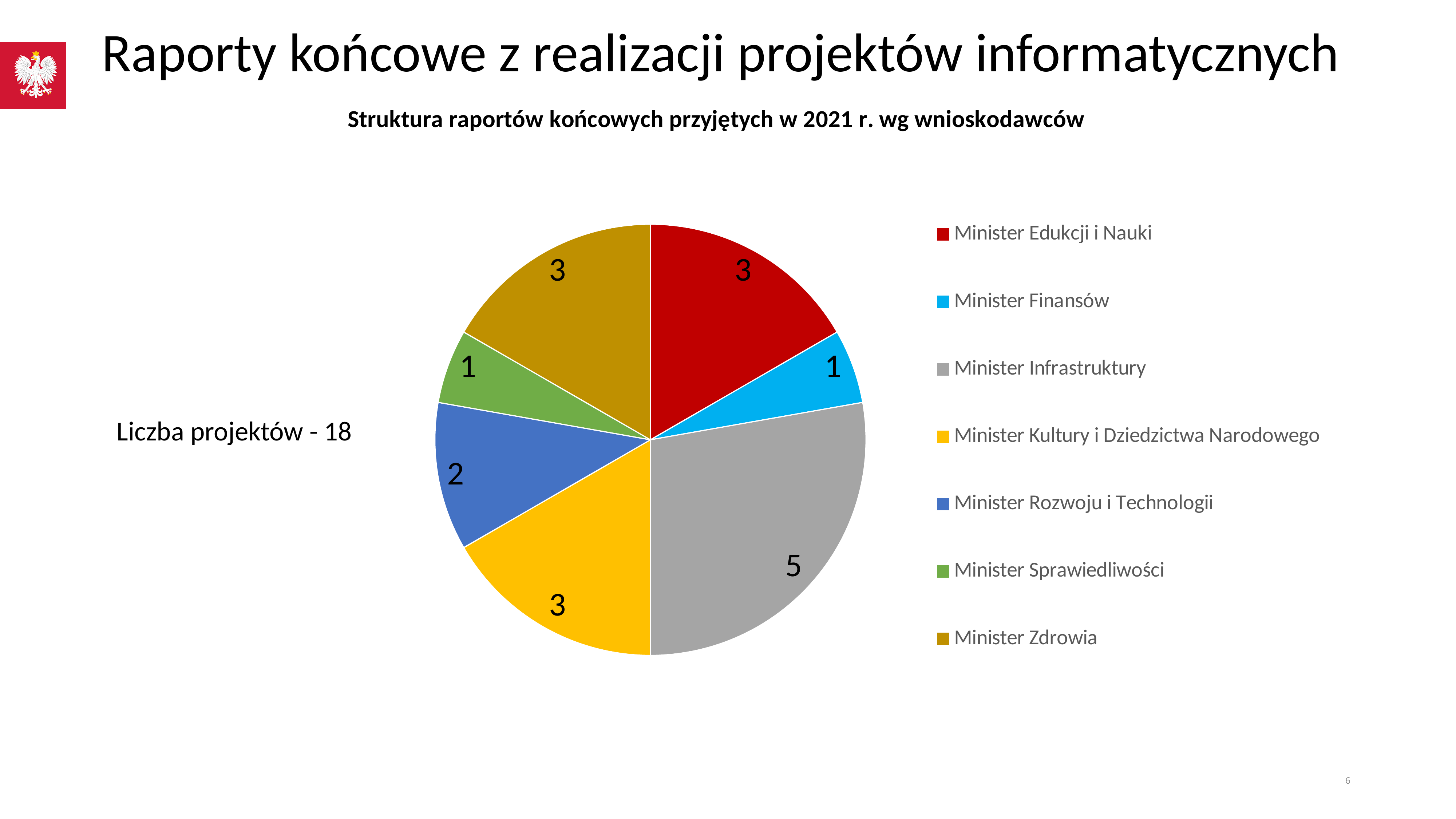
Which is larger: the value for Minister Edukacji i Nauki or the value for Minister Rozwoju i Technologii? Minister Edukcji i Nauki What is the total number of projects across all slices of the pie chart? 18 What is the difference between the values for Minister Infrastruktury and Minister Sprawiedliwości? 4 How many slices (applicants) does the pie chart have? 7 What value is shown for Minister Zdrowia? 3 Which applicant is represented by the grey slice in the pie chart? Minister Infrastruktury What is the title of the chart? Struktura raportów końcowych przyjętych w 2021 r. wg wnioskodawców How many projects are attributed to Minister Infrastruktury in the pie chart? 5 What value is shown for Minister Finansów? 1 What type of chart is shown on the slide? pie chart Which applicant has the largest slice of the pie chart? Minister Infrastruktury What value is shown for Minister Rozwoju i Technologii? 2